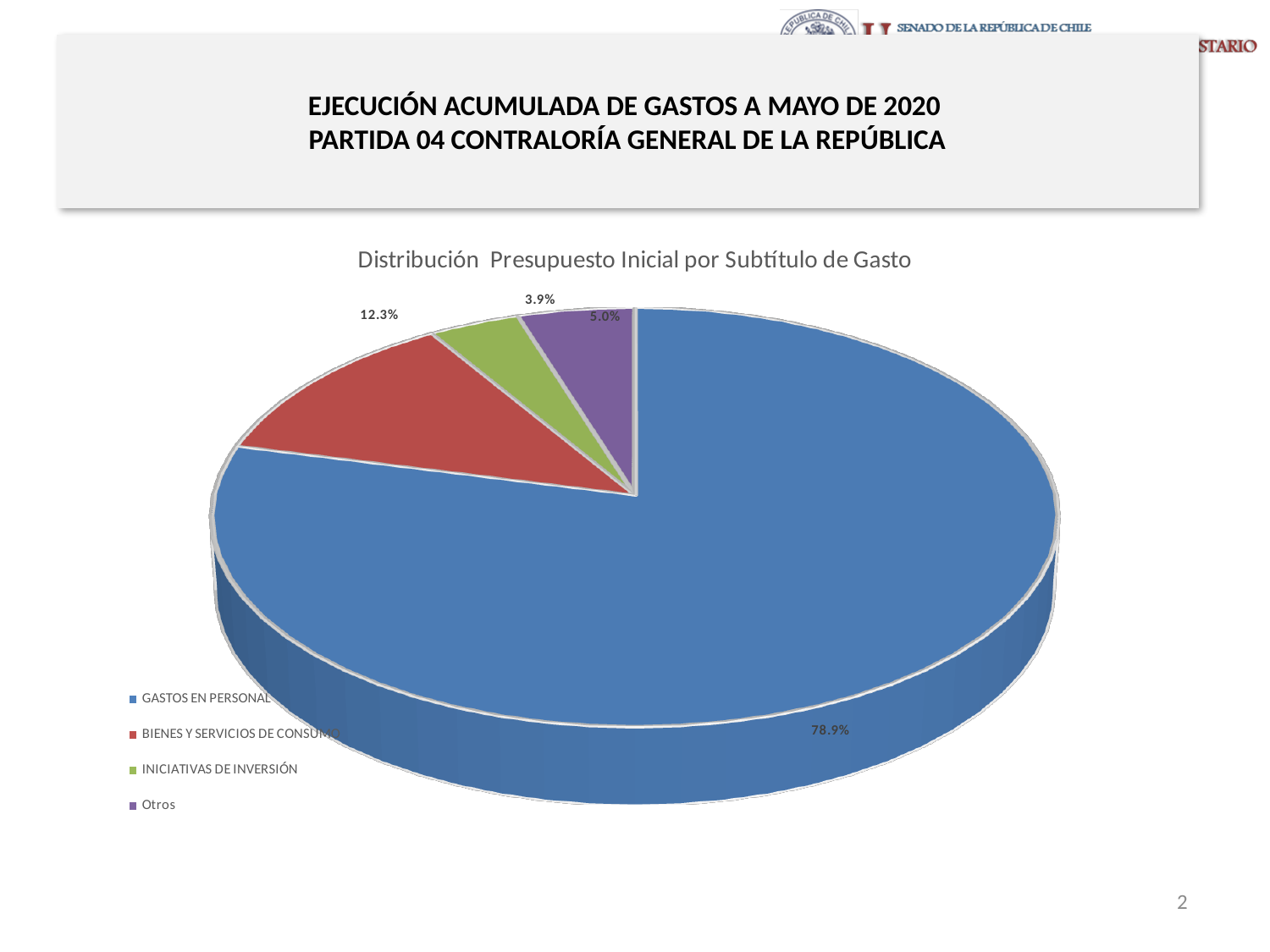
Which category has the smallest slice of the pie? INICIATIVAS DE INVERSIÓN What share of the pie does GASTOS EN PERSONAL represent? 78.9% What kind of chart is shown on the slide? Pie chart How many categories does the legend list? 4 Which is larger, the share for Otros or the share for INICIATIVAS DE INVERSIÓN? Otros What share of the pie does Otros represent? 5.0% Which category has the largest slice of the pie? GASTOS EN PERSONAL What share of the pie does INICIATIVAS DE INVERSIÓN represent? 3.9% What is the difference in percentage points between GASTOS EN PERSONAL and BIENES Y SERVICIOS DE CONSUMO? 66.6 What colour is the slice for BIENES Y SERVICIOS DE CONSUMO? Red What is the title of the chart? Distribución Presupuesto Inicial por Subtítulo de Gasto